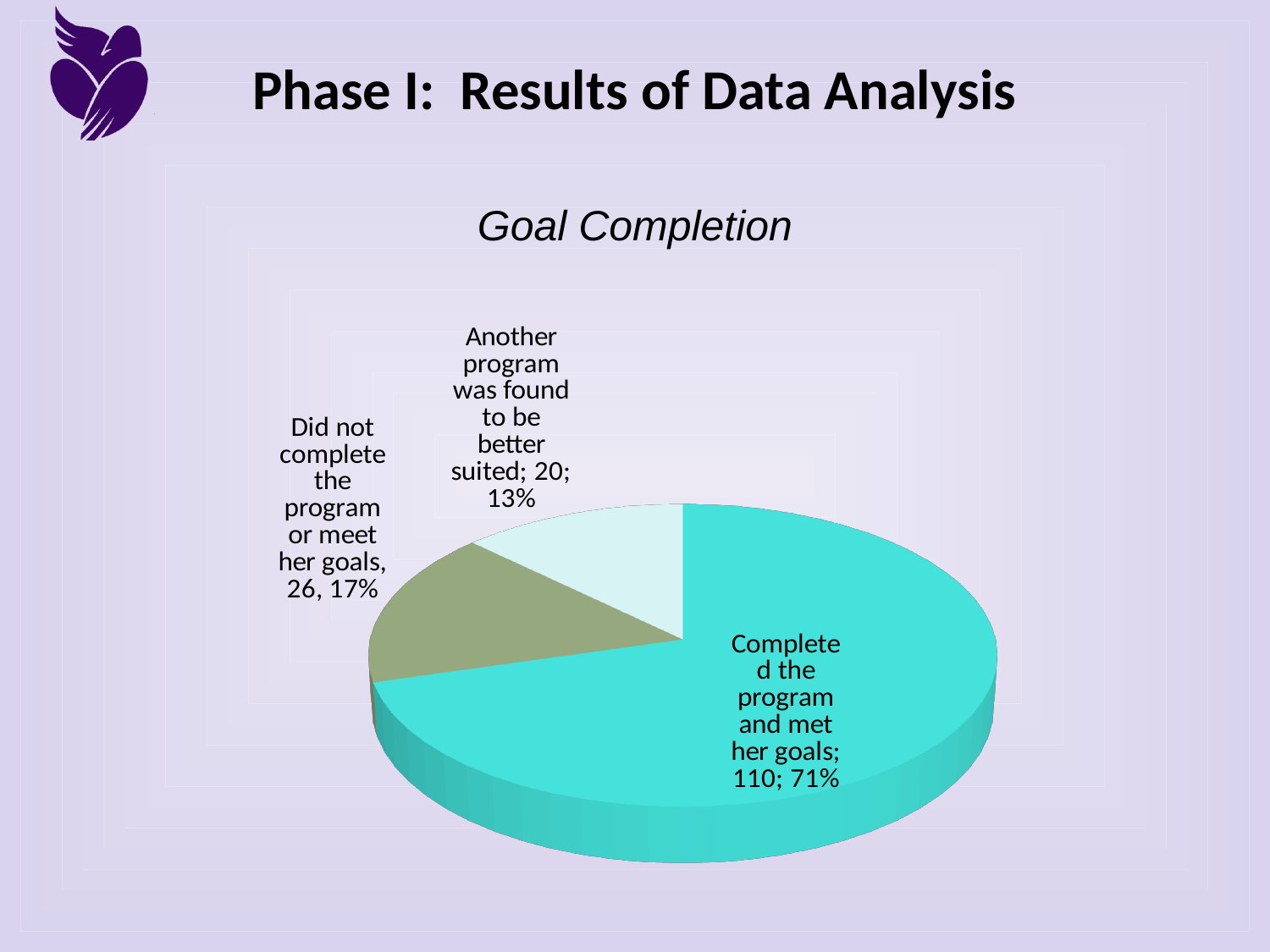
What kind of chart is shown on the slide? pie chart What share of the pie is 'Did not complete the program or meet her goals'? 17% Which category has the largest slice? Completed the program and met her goals What is the title of the chart? Goal Completion How many women completed the program and met their goals? 110 Which category has the smallest slice? Another program was found to be better suited How many women did not complete the program or meet their goals? 26 How many slices does the pie chart have? 3 What percentage of the pie is 'Another program was found to be better suited'? 13% What is the value for 'Another program was found to be better suited'? 20 What percentage of the pie is 'Completed the program and met her goals'? 71% What is the difference between the number who completed the program and met her goals and the number who did not complete the program or meet her goals? 84